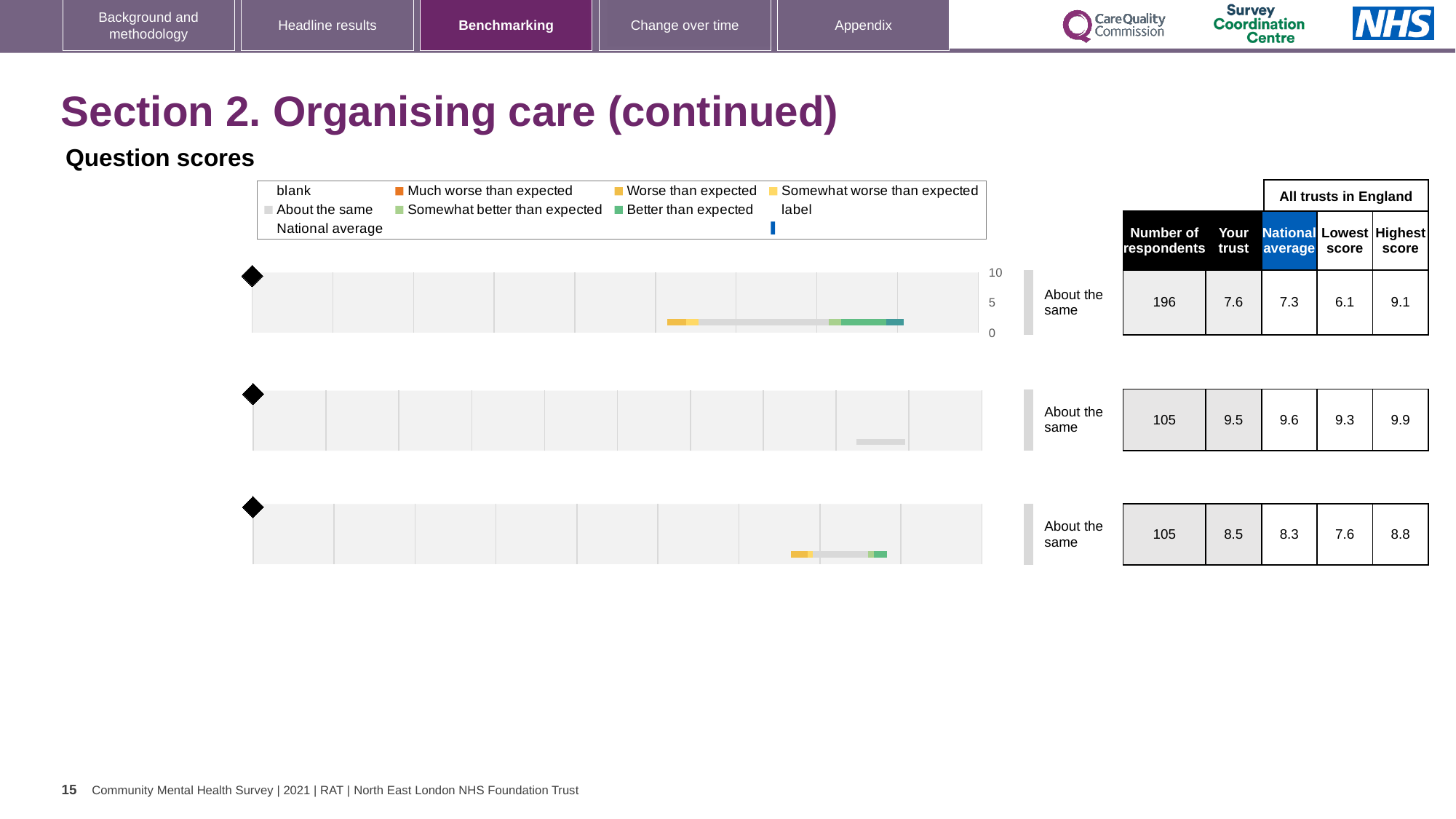
What benchmark category is shown next to the bottom chart? About the same For the top chart, which is larger: the 'Your trust' score or the national average? Your trust For the top chart, what is the 'Your trust' score shown in the table? 7.6 What kind of chart is used for the three benchmarking charts on the slide? bar chart For the middle chart, what is the difference between the national average and the 'Your trust' score? 0.1 For the bottom chart, what is the difference between the highest score and the lowest score? 1.2 For the middle chart, how many respondents are listed? 105 Which chart (top, middle or bottom) has the highest 'Your trust' score? middle For the bottom chart, what is the highest score among all trusts in England? 8.8 What is the maximum value shown on the score axis of the top chart? 10 For the top chart, what is the national average score? 7.3 How many benchmarking charts are shown on the slide? 3